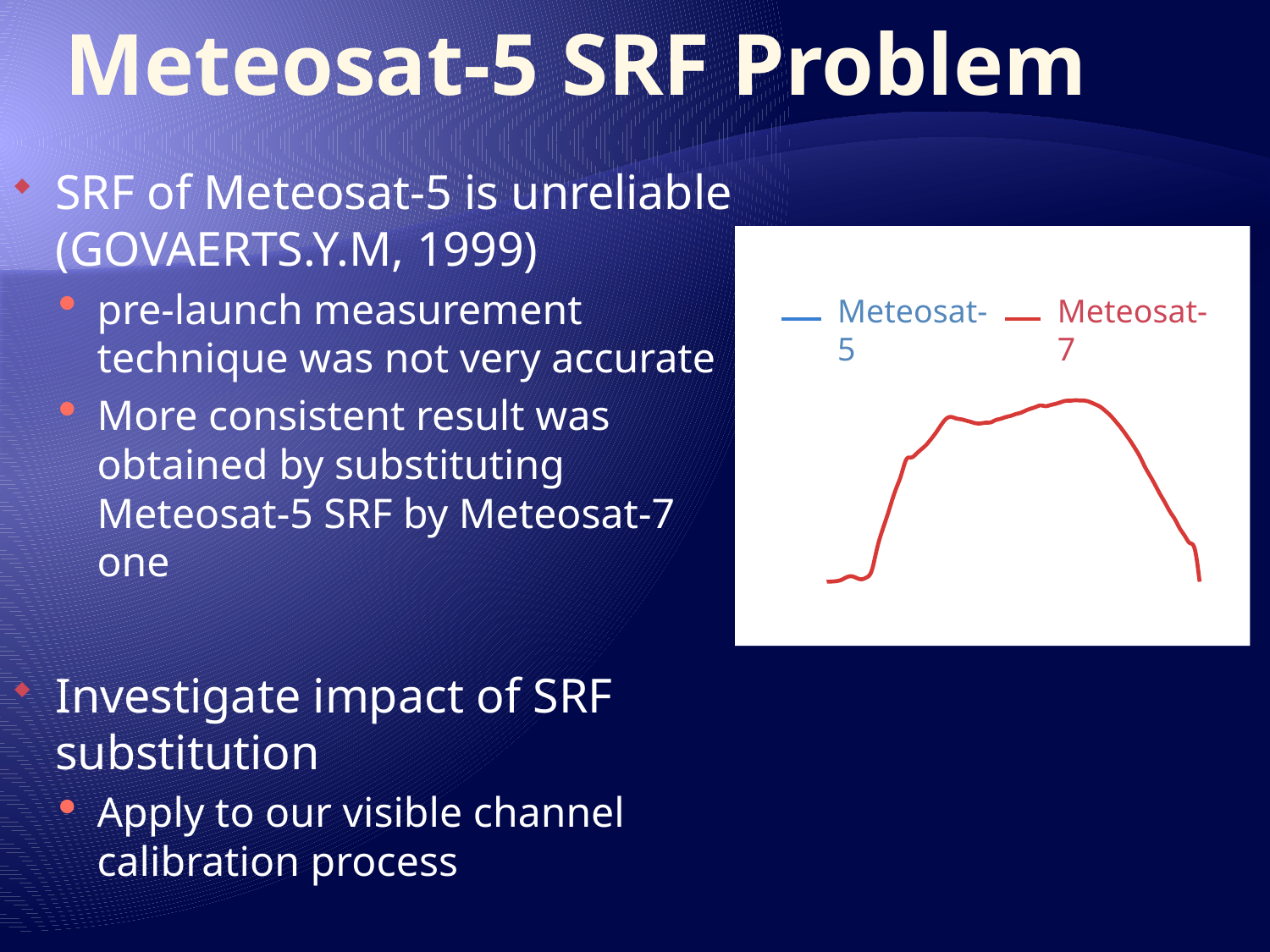
At the right-hand end of the chart, is the Meteosat-7 line rising or falling? falling How many series does the chart's legend list? 2 What kind of chart is shown on the slide? line chart Moving left to right along the x axis, does the Meteosat-7 line first rise or first fall? rise What colour is the Meteosat-7 line in the chart? red Which two series are listed in the chart's legend? Meteosat-5 and Meteosat-7